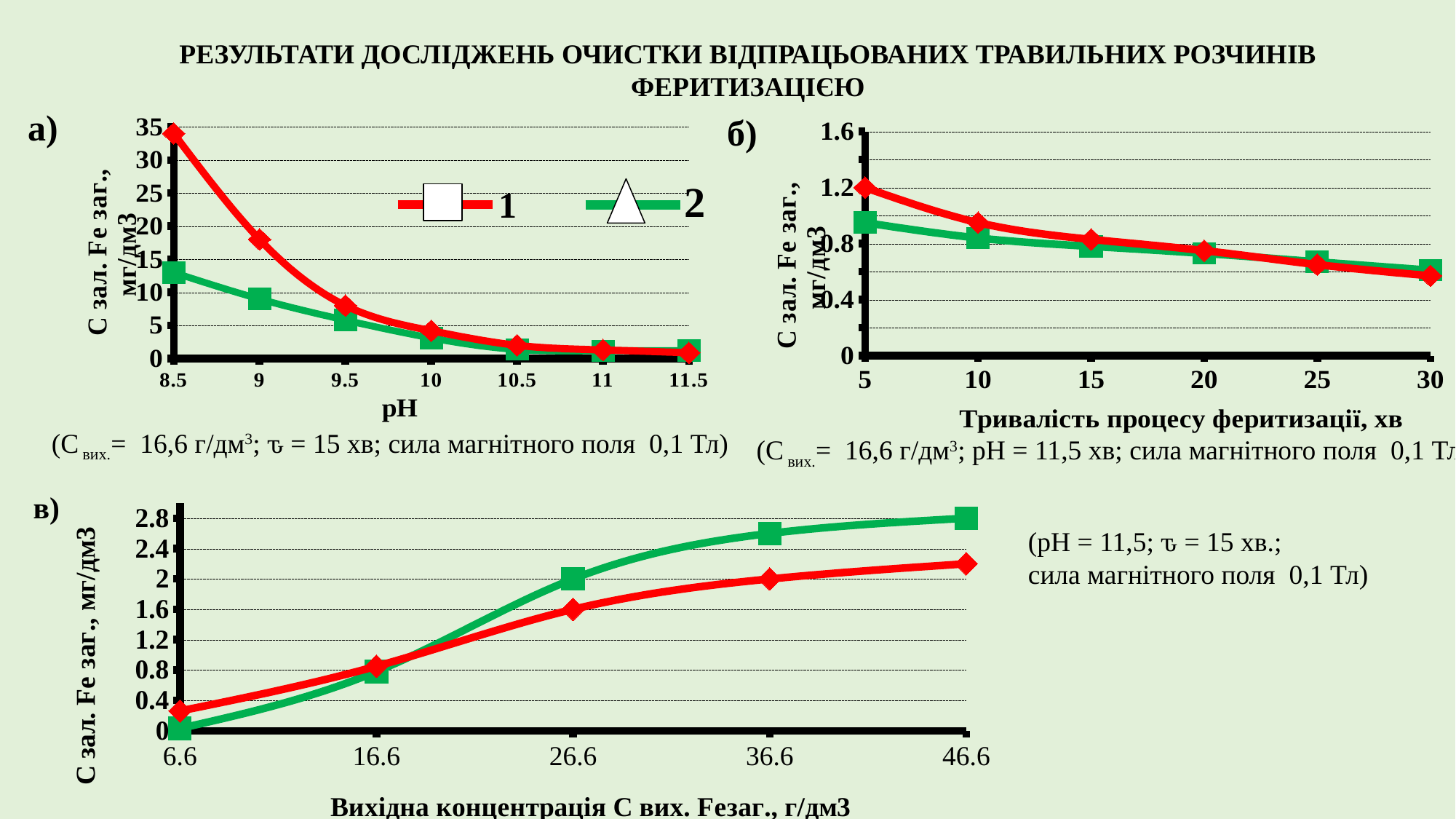
On chart в), is the value of series 2 at 36.6 г/дм3 greater or less than 2.4? greater On chart а), is the value of series 1 at pH 8.5 greater or less than 30? greater On chart б), how many time points are plotted along the x axis? 6 On chart а), which series has the higher value at pH 9? 1 On chart б), is the value of series 1 at 5 хв greater or less than 0.8? greater What kind of chart is chart а)? line chart On chart б), do the values of series 1 rise or fall as the process duration increases? fall On chart а), do the values of series 1 rise or fall as pH increases? fall How many series does the legend on chart а) list? 2 On chart а), how many pH values are plotted along the x axis? 7 On chart в), which series has the higher value at 46.6 г/дм3? 2